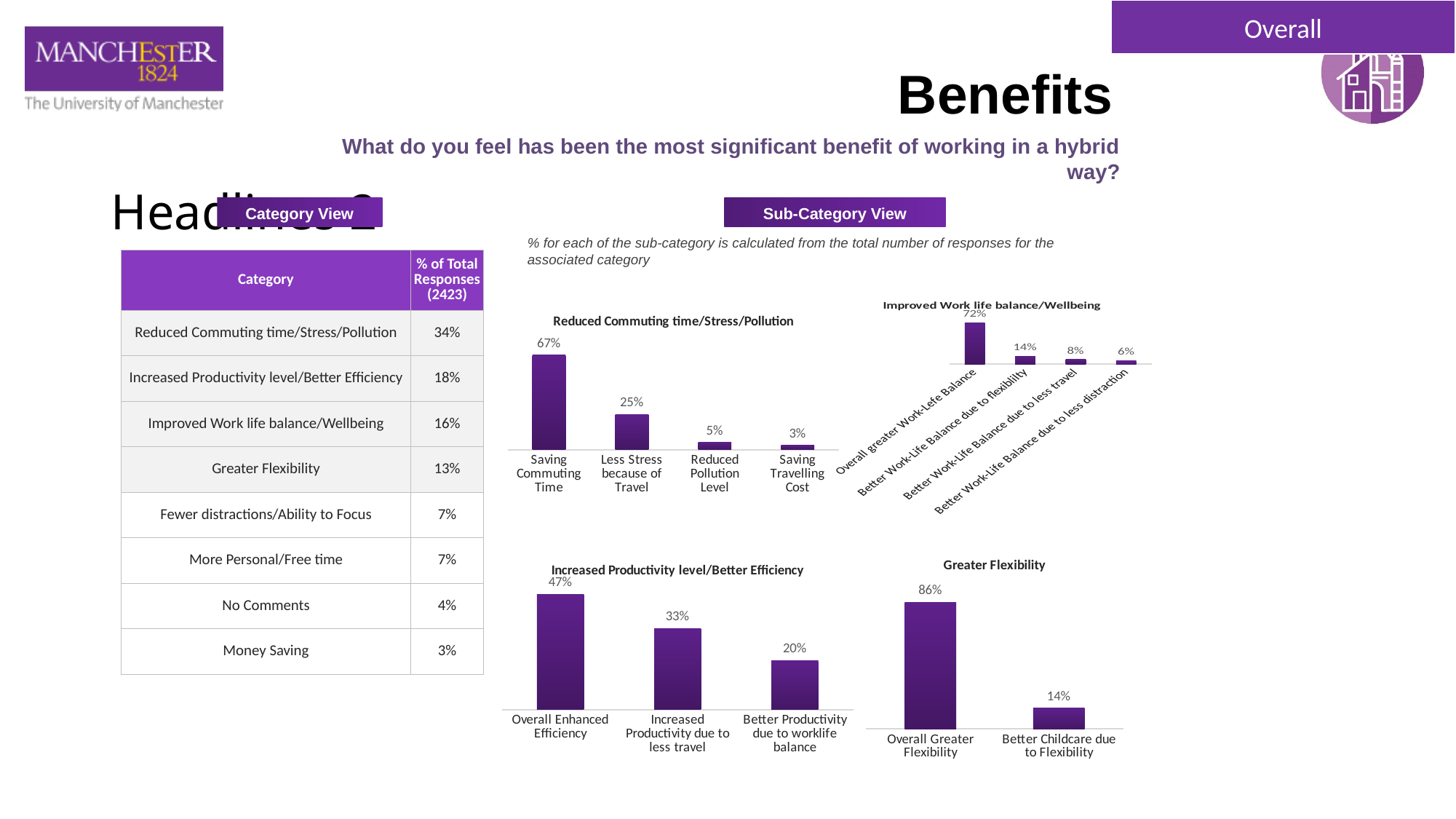
In the 'Greater Flexibility' chart, what is the value for Better Childcare due to Flexibility? 14% In the 'Reduced Commuting time/Stress/Pollution' chart, what is the difference between Saving Commuting Time and Less Stress because of Travel? 42% In the 'Improved Work life balance/Wellbeing' chart, which category has the highest value? Overall greater Work-Life Balance How many categories are shown in the 'Reduced Commuting time/Stress/Pollution' chart? 4 In the 'Reduced Commuting time/Stress/Pollution' chart, what is the value for Saving Commuting Time? 67% In the 'Increased Productivity level/Better Efficiency' chart, do the values rise or fall from left to right? fall In the 'Greater Flexibility' chart, what is the difference between Overall Greater Flexibility and Better Childcare due to Flexibility? 72% What kind of chart is the 'Greater Flexibility' chart? bar chart In the 'Reduced Commuting time/Stress/Pollution' chart, which category has the lowest value? Saving Travelling Cost In the 'Improved Work life balance/Wellbeing' chart, which is larger: Better Work-Life Balance due to less travel or Better Work-Life Balance due to less distraction? Better Work-Life Balance due to less travel In the 'Improved Work life balance/Wellbeing' chart, what is the value for Better Work-Life Balance due to flexibility? 14% In the 'Increased Productivity level/Better Efficiency' chart, what is the value for Increased Productivity due to less travel? 33%